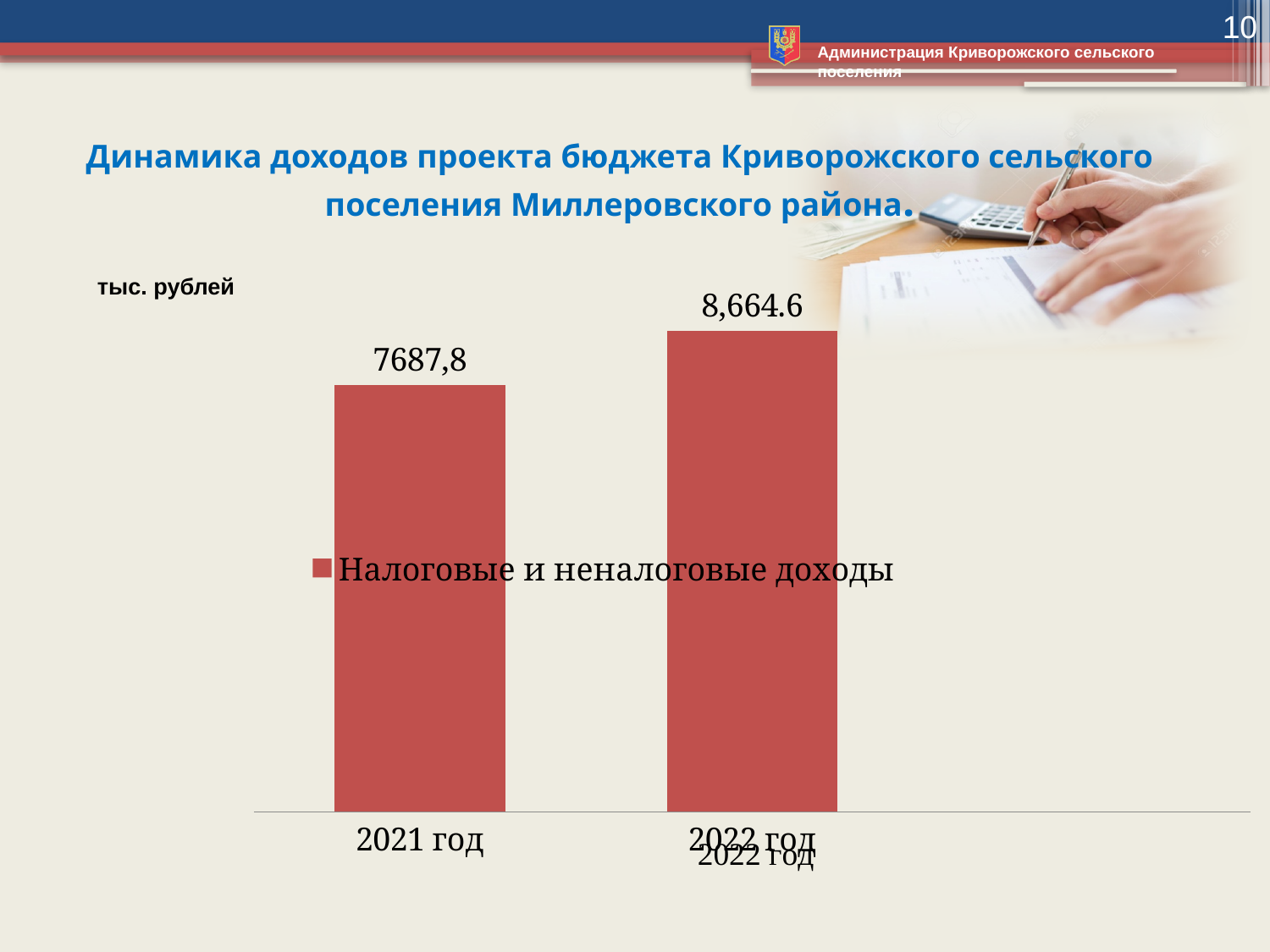
Which year has the highest value? 2022 год What is the difference between the values for 2022 год and 2021 год? 976,8 What series name is shown in the chart legend? Налоговые и неналоговые доходы In what units are the chart values given? тыс. рублей What kind of chart is shown on the slide? bar chart Which is larger, the value for 2021 год or for 2022 год? 2022 год What is the value for 2022 год? 8,664.6 Which year has the lowest value? 2021 год Do the values rise or fall from 2021 год to 2022 год? rise How many series does the legend list? 1 How many bars are shown in the chart? 2 What is the value for 2021 год? 7687,8